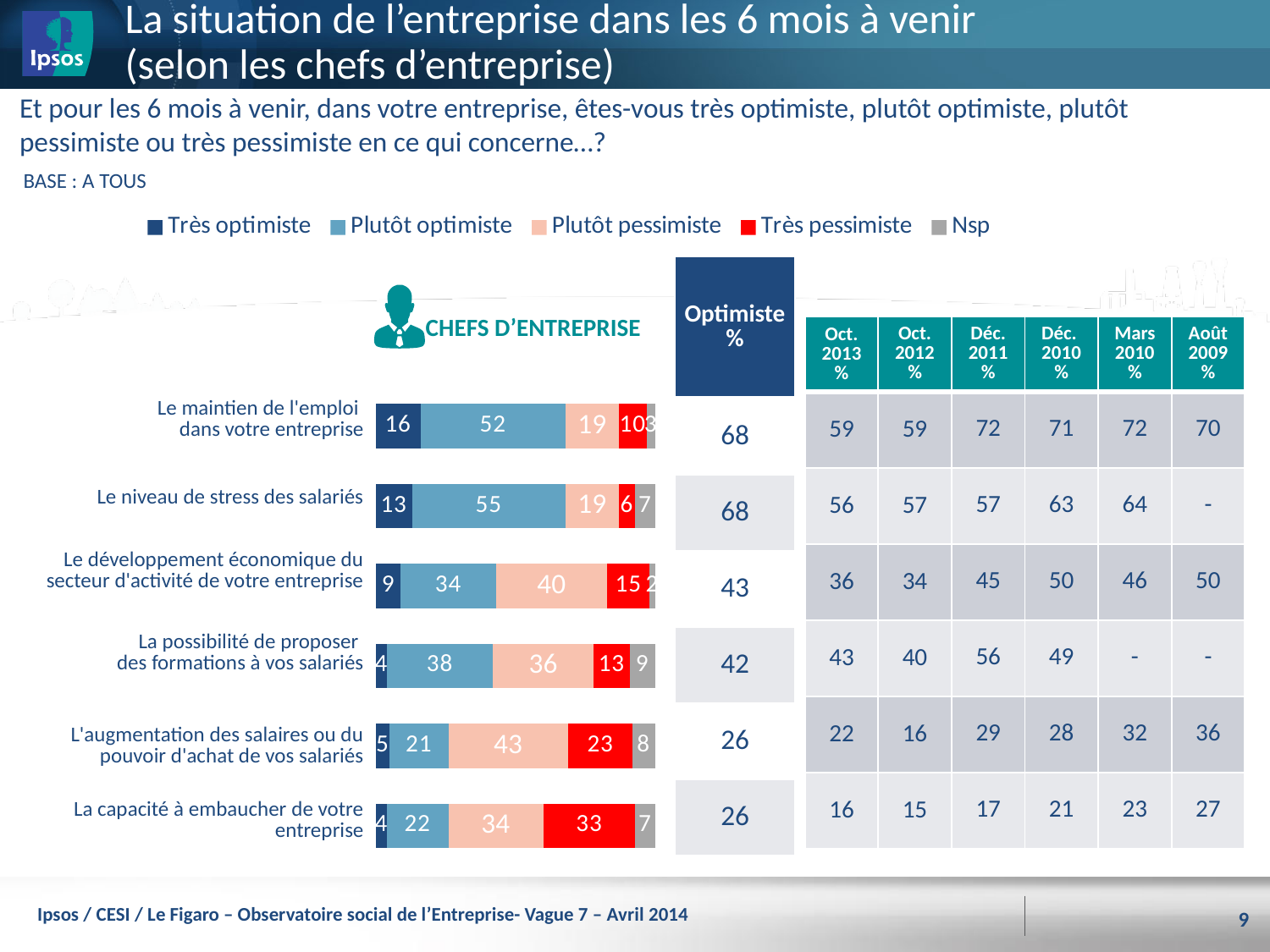
What type of chart is shown on the slide? Stacked bar chart What is the 'Très pessimiste' value for 'La capacité à embaucher de votre entreprise'? 33 Which is larger: the 'Très pessimiste' value for 'La possibilité de proposer des formations à vos salariés' or for 'L'augmentation des salaires ou du pouvoir d'achat de vos salariés'? L'augmentation des salaires ou du pouvoir d'achat de vos salariés What is the 'Plutôt pessimiste' value for 'L'augmentation des salaires ou du pouvoir d'achat de vos salariés'? 43 What is the 'Plutôt optimiste' value for 'Le niveau de stress des salariés'? 55 How many categories (items) are plotted in the chart? 6 Which colour represents 'Très pessimiste' in the chart legend? Red What is the difference between the 'Plutôt optimiste' values for 'Le maintien de l'emploi dans votre entreprise' and 'Le développement économique du secteur d'activité de votre entreprise'? 18 Which category has the lowest 'Plutôt optimiste' value? L'augmentation des salaires ou du pouvoir d'achat de vos salariés How many series does the chart legend list? 5 Which category has the highest 'Très optimiste' value? Le maintien de l'emploi dans votre entreprise What is the combined 'Très optimiste' plus 'Plutôt optimiste' total for 'Le développement économique du secteur d'activité de votre entreprise'? 43